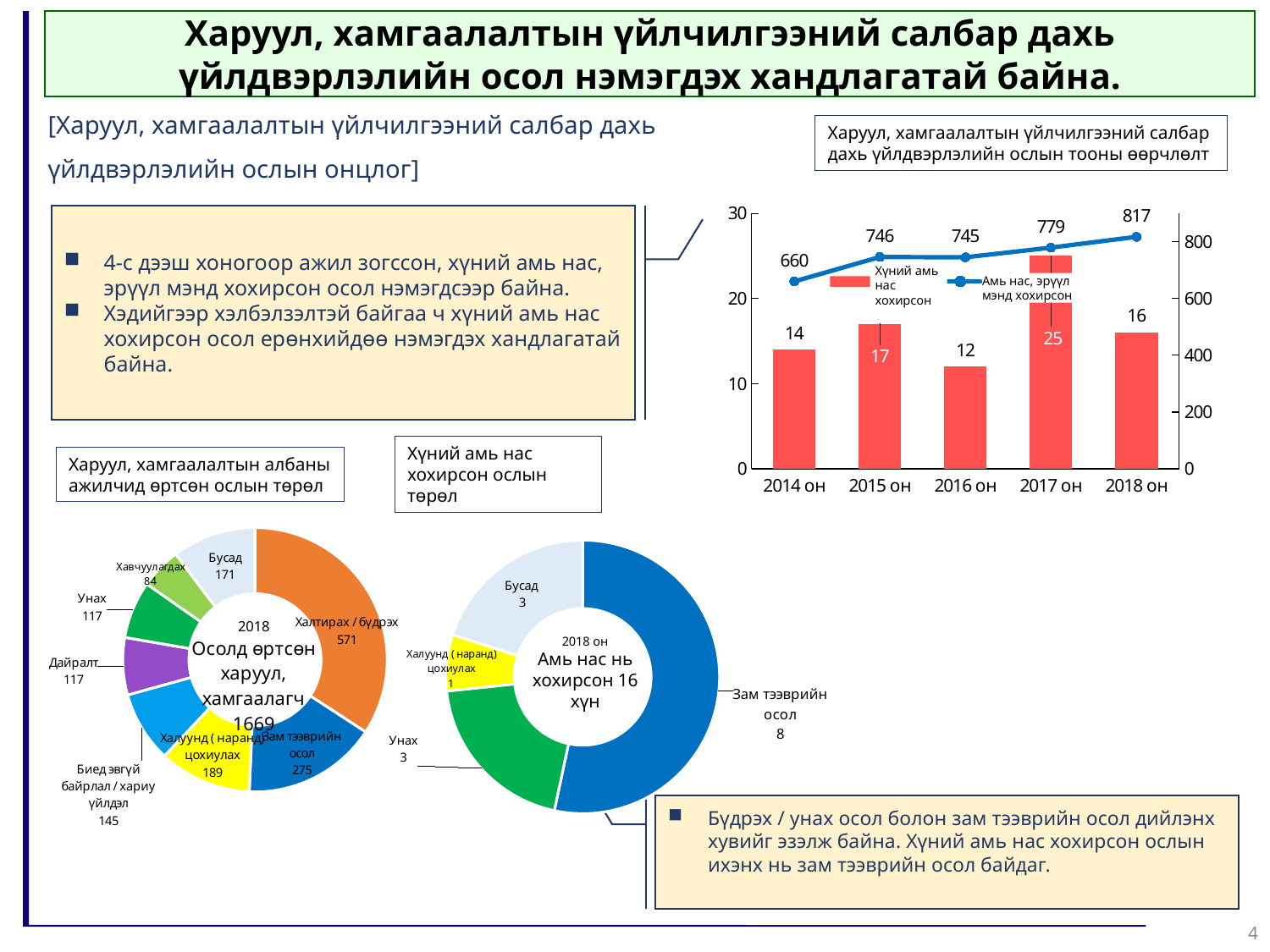
In the bottom-left donut chart (Харуул, хамгаалалтын албаны ажилчид өртсөн ослын төрөл), what is the value for Халтирах / бүдрэх? 571 In the top-right chart on the number of accidents, what is the value of the line (Амь нас, эрүүл мэнд хохирсон) for 2018 он? 817 In the top-right chart on the number of accidents, how many series does the legend list? 2 In the bottom-left donut chart (Харуул, хамгаалалтын албаны ажилчид өртсөн ослын төрөл), which is larger: Зам тээврийн осол or Халуунд (наранд) цохиулах? Зам тээврийн осол In the bottom-middle donut chart (Хүний амь нас хохирсон ослын төрөл), what is the value for Зам тээврийн осол? 8 In the top-right chart on the number of accidents, what is the value of the bar for 2017 он? 25 In the top-right chart on the number of accidents, how many years are shown on the x axis? 5 What type of chart is the bottom-left chart showing accident types for guards? Donut (pie) chart In the bottom-left donut chart (Харуул, хамгаалалтын албаны ажилчид өртсөн ослын төрөл), which category has the smallest value? Хавчуулагдах In the top-right chart on the number of accidents, which year has the highest bar value? 2017 он In the top-right chart on the number of accidents, what is the difference between the line values for 2018 он and 2014 он? 157 In the top-right chart on the number of accidents, which year has the lowest line value? 2014 он